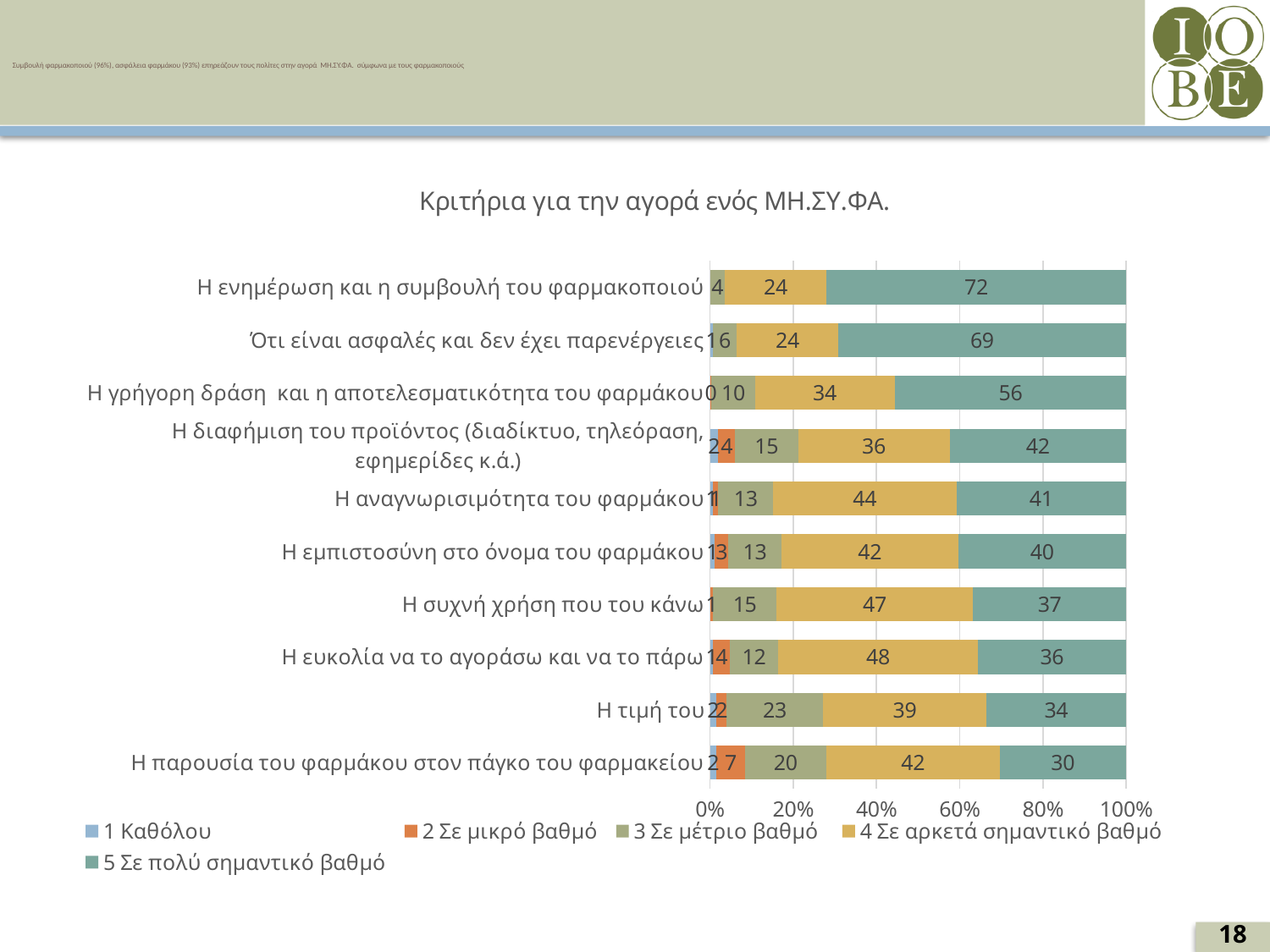
How many categories (criteria) are plotted in the chart? 10 What is the difference in the '5 Σε πολύ σημαντικό βαθμό' value between 'Η ενημέρωση και η συμβουλή του φαρμακοποιού' and 'Ότι είναι ασφαλές και δεν έχει παρενέργειες'? 3 Which category has the highest value for '5 Σε πολύ σημαντικό βαθμό'? Η ενημέρωση και η συμβουλή του φαρμακοποιού How many series does the legend list? 5 What is the title of the chart? Κριτήρια για την αγορά ενός ΜΗ.ΣΥ.ΦΑ. What is the value of '5 Σε πολύ σημαντικό βαθμό' for 'Η ενημέρωση και η συμβουλή του φαρμακοποιού'? 72 Which category has the lowest value for '5 Σε πολύ σημαντικό βαθμό'? Η παρουσία του φαρμάκου στον πάγκο του φαρμακείου What is the value of '5 Σε πολύ σημαντικό βαθμό' for 'Η γρήγορη δράση και η αποτελεσματικότητα του φαρμάκου'? 56 What kind of chart is shown on the slide? Stacked bar chart What is the value of '4 Σε αρκετά σημαντικό βαθμό' for 'Η ευκολία να το αγοράσω και να το πάρω'? 48 What is the value of '3 Σε μέτριο βαθμό' for 'Η τιμή του'? 23 Which has the larger '4 Σε αρκετά σημαντικό βαθμό' value: 'Η τιμή του' or 'Η συχνή χρήση που του κάνω'? Η συχνή χρήση που του κάνω